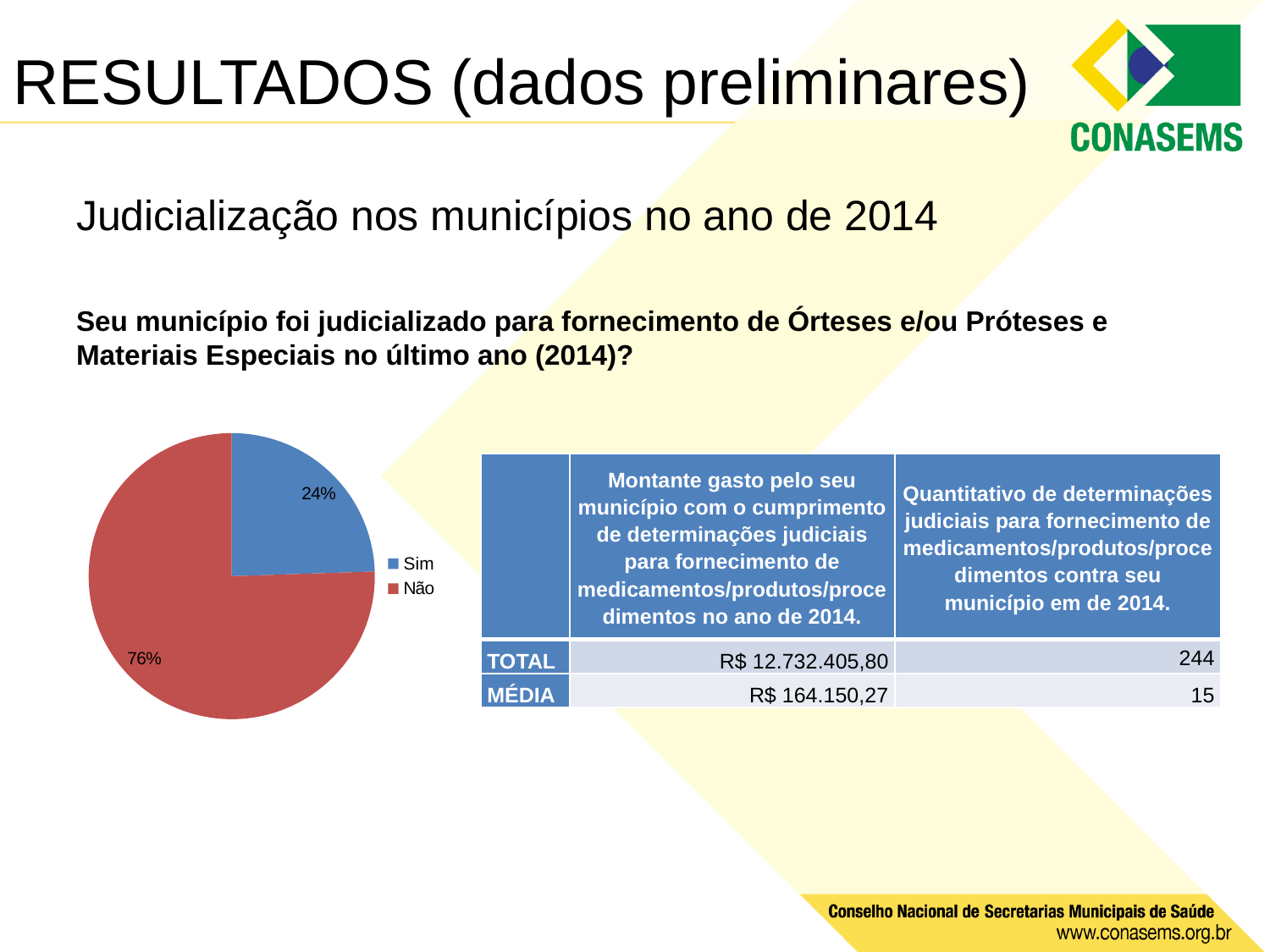
What colour is the "Não" slice in the pie chart? red How many entries does the pie chart's legend list? 2 What is the difference in percentage points between the "Não" and "Sim" slices of the pie chart? 52 What colour is the "Sim" slice in the pie chart? blue What kind of chart is shown on the slide? pie chart Which slice of the pie chart is the smallest? Sim How many slices does the pie chart have? 2 Which slice of the pie chart is the largest? Não What share of the pie chart is labelled "Sim"? 24% Which is larger in the pie chart, "Sim" or "Não"? Não What share of the pie chart is labelled "Não"? 76%